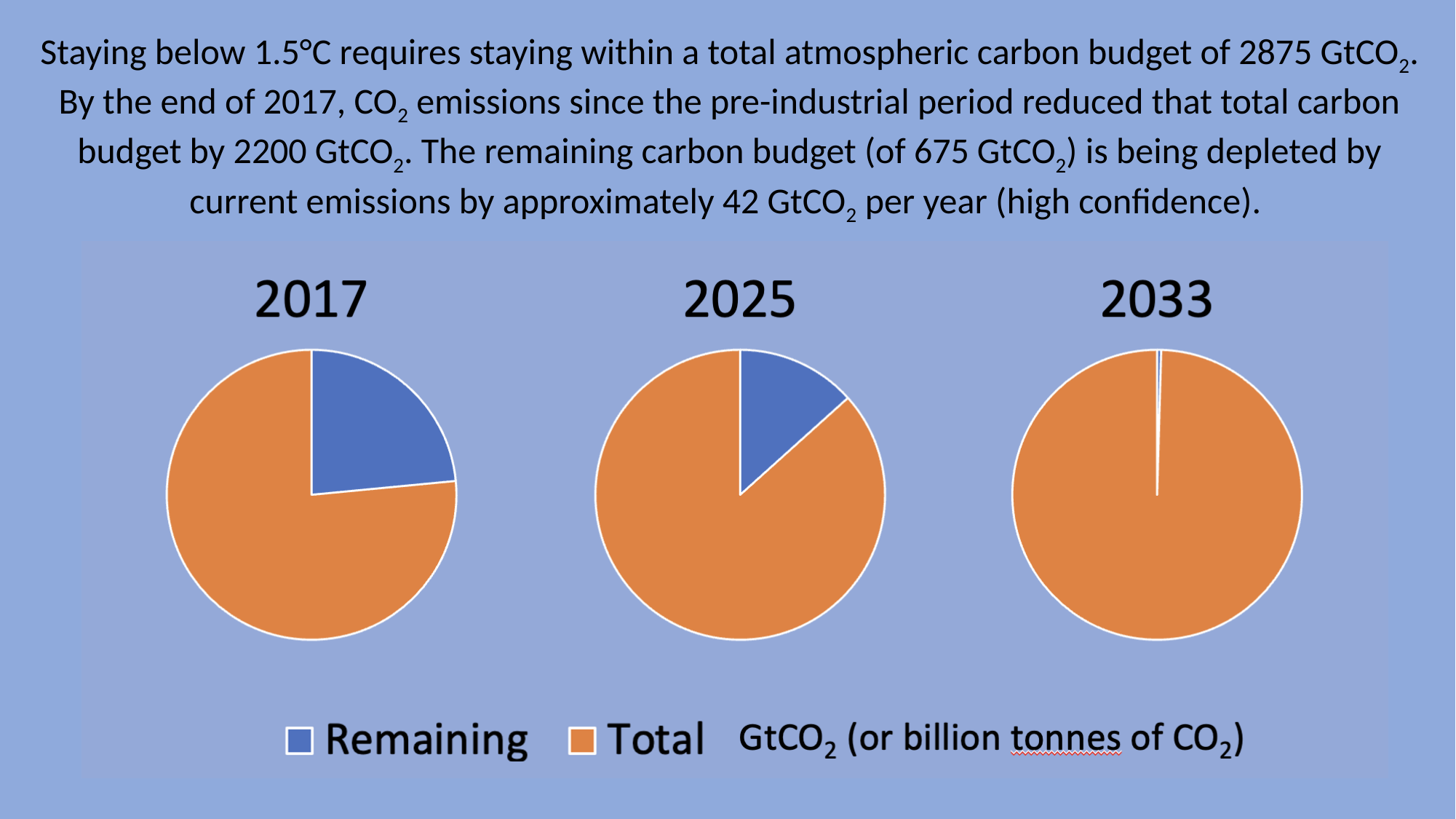
How many series does the legend list? 2 In the 2033 pie chart, which slice is larger, Remaining or Total? Total In the 2025 pie chart, which slice is smaller, Remaining or Total? Remaining What colour represents the Remaining series in the pie charts? blue Which of the three pie charts has the smallest Remaining slice? 2033 Across the 2017, 2025 and 2033 pie charts, does the Remaining slice grow or shrink over time? shrink Which of the three pie charts has the largest Remaining slice? 2017 How many pie charts are shown on the slide? 3 What kind of chart is used for the 2017 chart? pie chart In the 2017 pie chart, which slice is larger, Remaining or Total? Total What are the titles of the three pie charts, from left to right? 2017, 2025, 2033